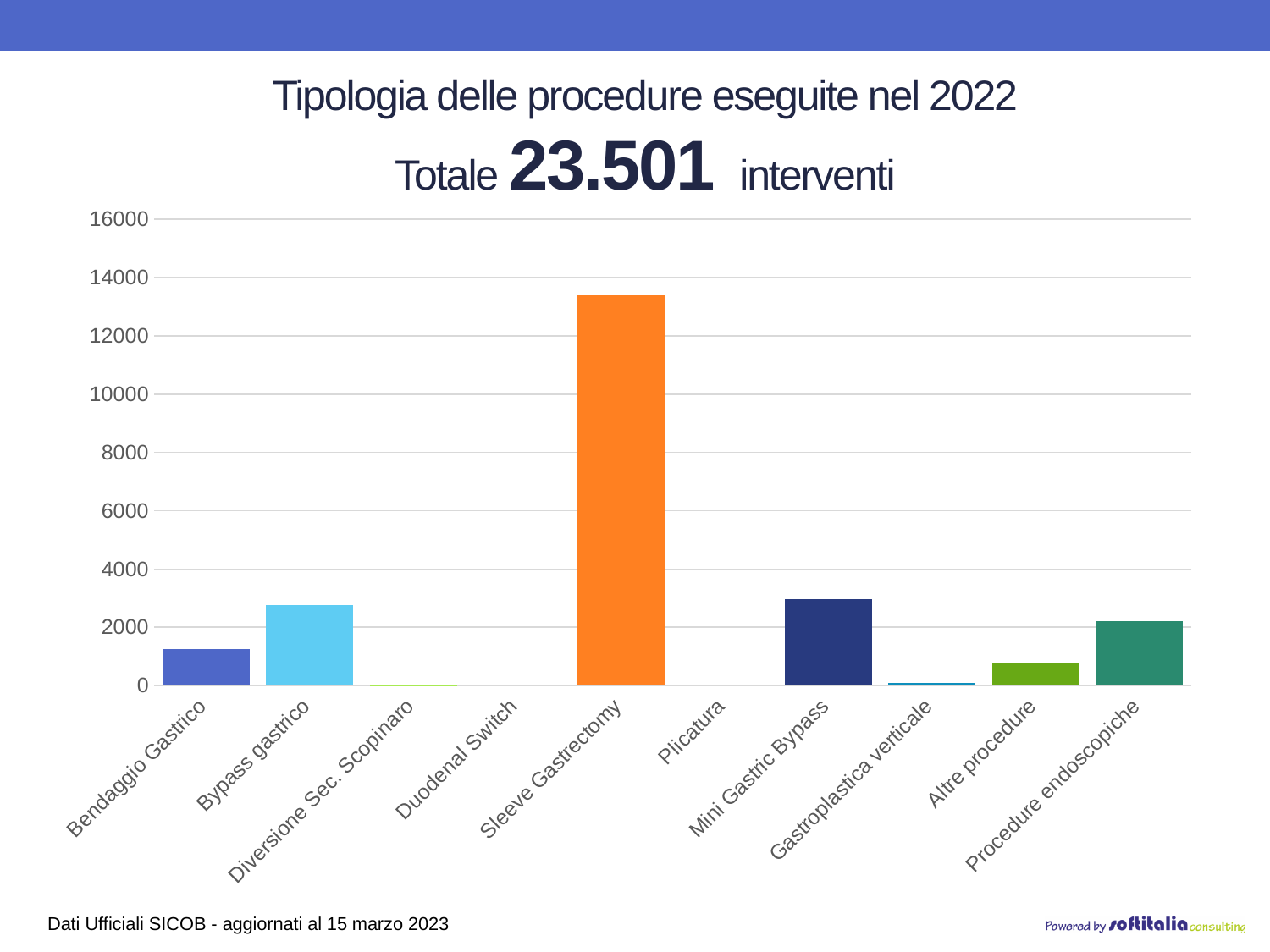
Is the value for Sleeve Gastrectomy greater or less than 12000? greater Which is larger, the value for Altre procedure or the value for Bendaggio Gastrico? Bendaggio Gastrico Is the value for Mini Gastric Bypass greater or less than 4000? less What total number of interventions is stated in the chart title? 23.501 Is the value for Bendaggio Gastrico greater or less than 2000? less What kind of chart is shown on the slide? bar chart Which procedure has the highest bar? Sleeve Gastrectomy Which is larger, the value for Bendaggio Gastrico or the value for Procedure endoscopiche? Procedure endoscopiche How many procedure categories are shown on the x axis? 10 What is the title of the chart? Tipologia delle procedure eseguite nel 2022